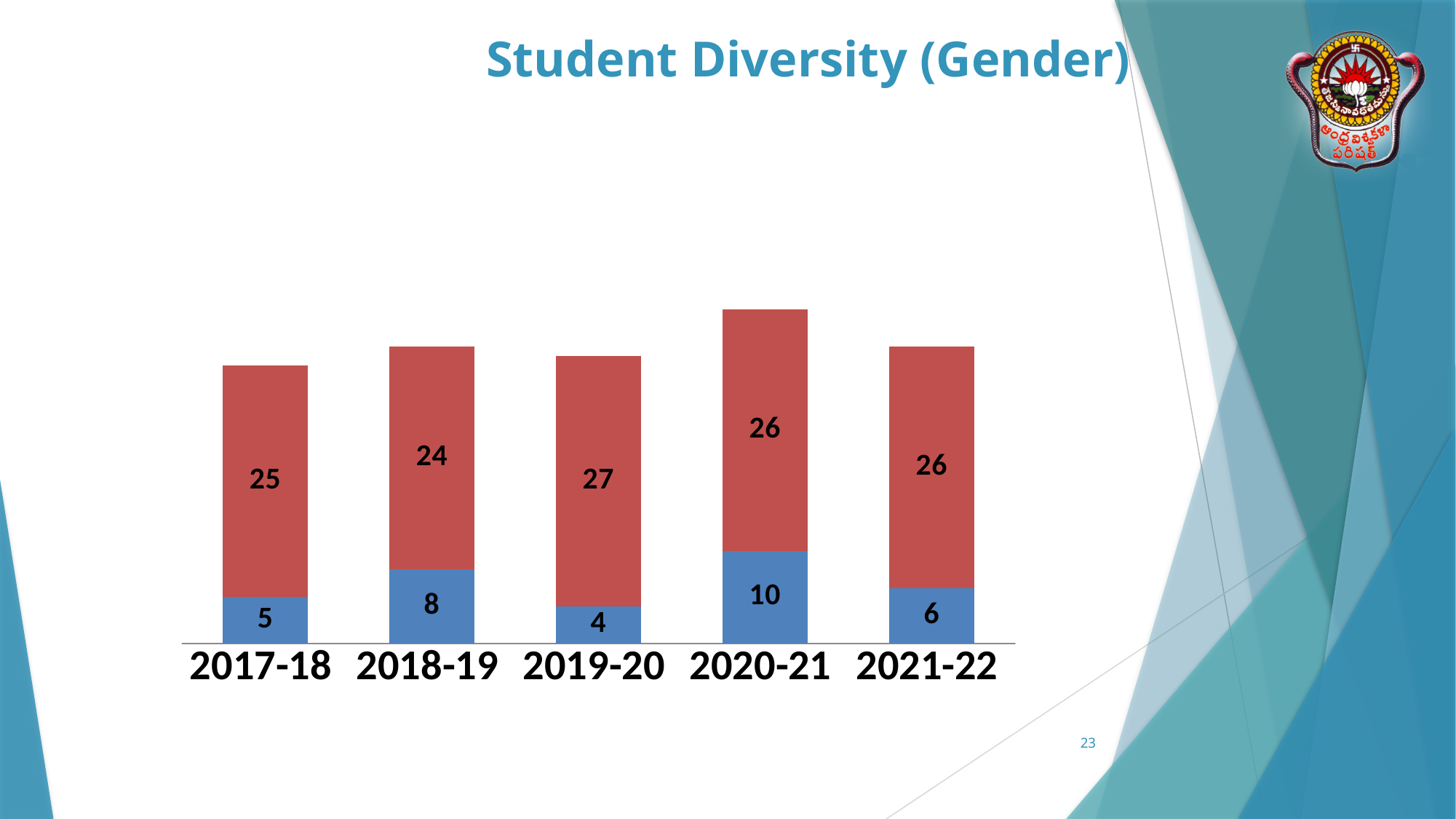
Which year has the lowest value for the blue segment? 2019-20 What is the difference between the red and blue segments for 2021-22? 20 How many years are shown on the x axis? 5 What is the value of the blue segment for 2017-18? 5 Which year has the highest value for the blue segment? 2020-21 What kind of chart is shown on the slide? Stacked bar chart What is the total of the stacked bar for 2020-21? 36 What is the value of the red segment for 2019-20? 27 Which year has the highest value for the red segment? 2019-20 Is the blue segment larger for 2018-19 or for 2021-22? 2018-19 What is the value of the blue segment for 2020-21? 10 What is the value of the red segment for 2018-19? 24